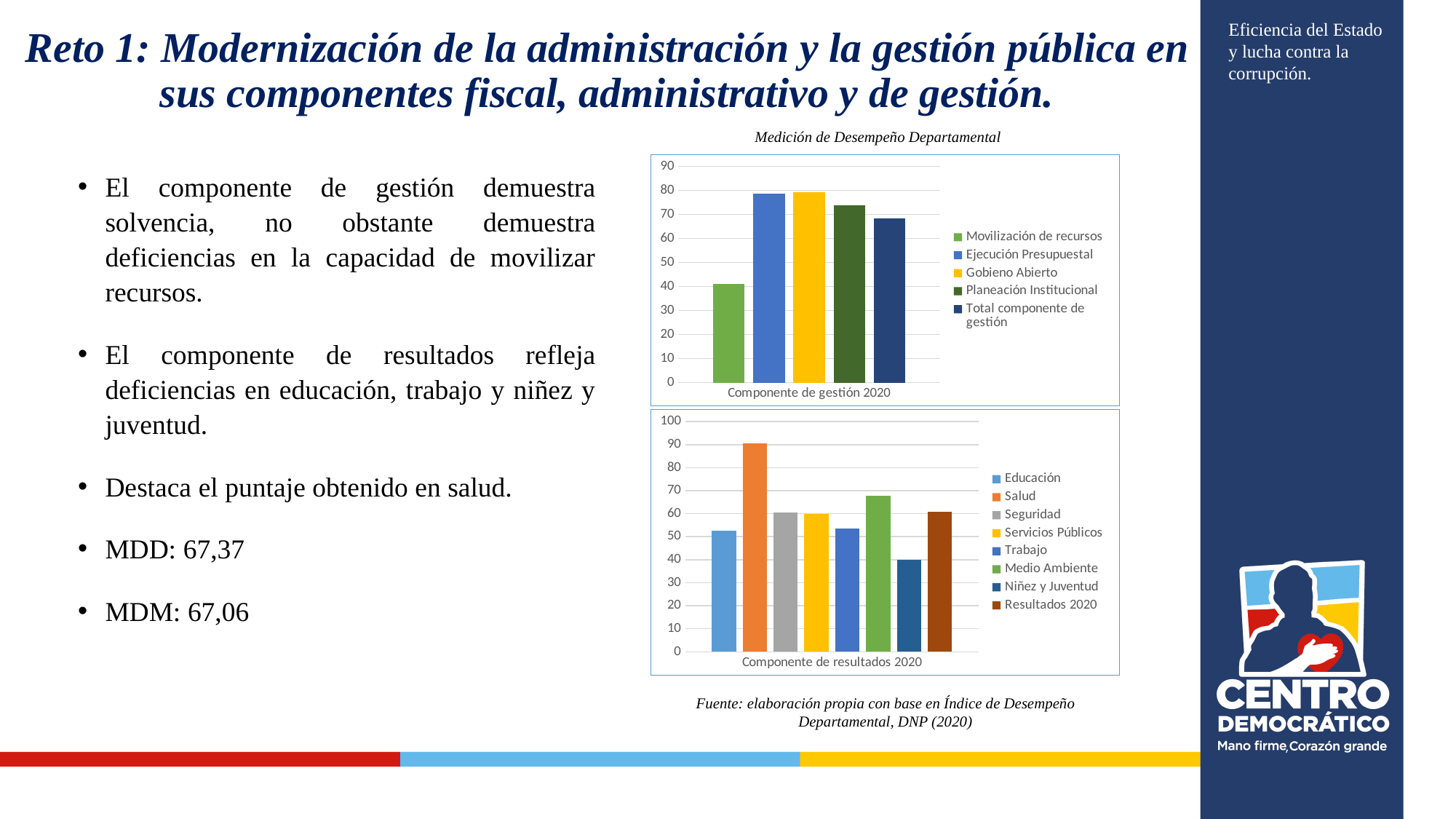
What kind of chart is the top chart, 'Componente de gestión 2020'? bar chart In the top chart ('Componente de gestión 2020'), is the value for Movilización de recursos greater or less than 50? less What is the title shown above the two charts? Medición de Desempeño Departamental In the bottom chart ('Componente de resultados 2020'), which series has the highest value? Salud In the bottom chart ('Componente de resultados 2020'), which is larger: Medio Ambiente or Trabajo? Medio Ambiente In the top chart ('Componente de gestión 2020'), which series has the lowest value? Movilización de recursos In the bottom chart ('Componente de resultados 2020'), is the value for Niñez y Juventud greater or less than 50? less In the top chart ('Componente de gestión 2020'), is the value for Planeación Institucional greater or less than 70? greater How many series does the legend of the bottom chart ('Componente de resultados 2020') list? 8 How many series does the legend of the top chart ('Componente de gestión 2020') list? 5 In the bottom chart ('Componente de resultados 2020'), which series has the lowest value? Niñez y Juventud